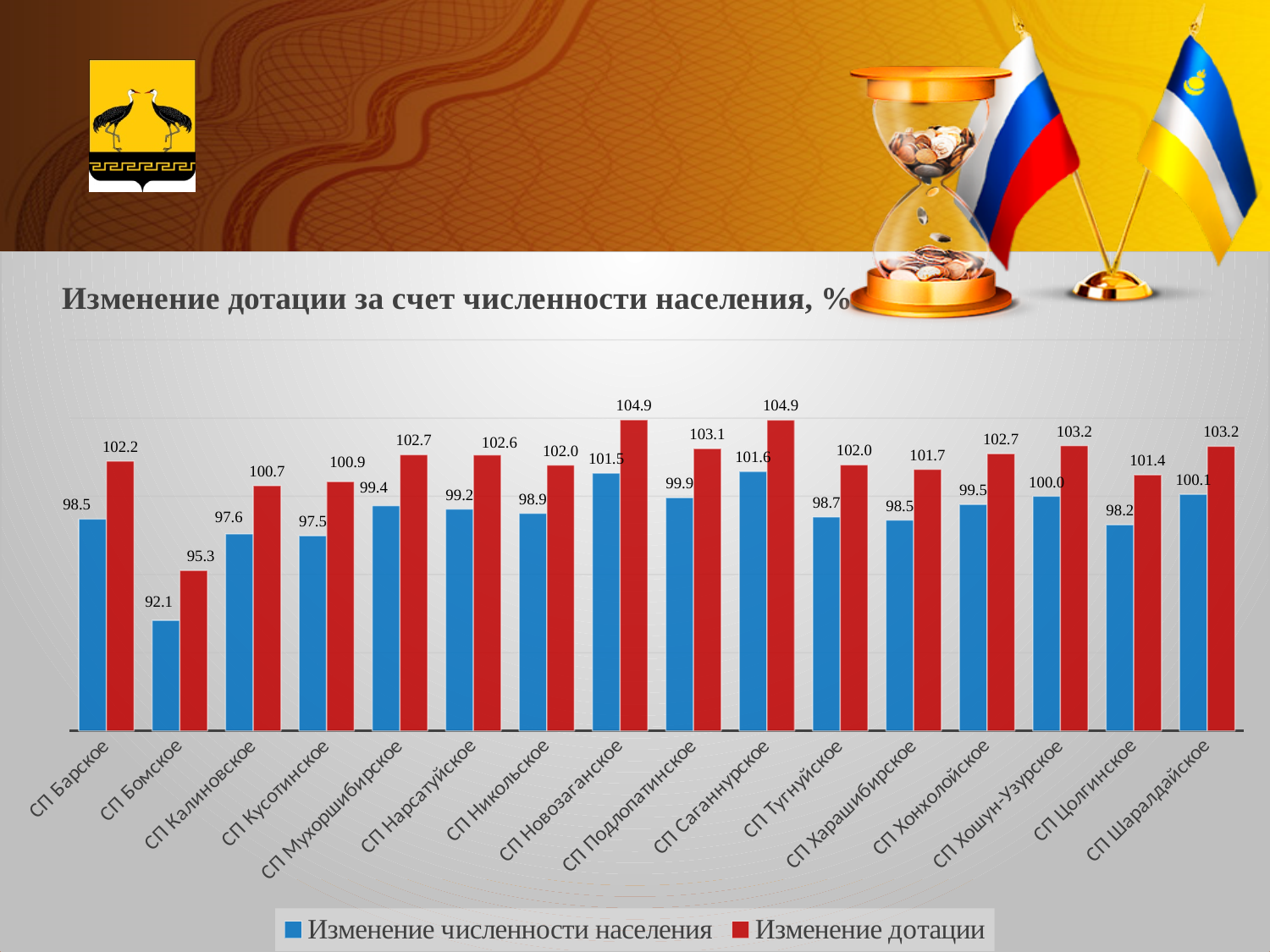
What is the difference between Изменение дотации and Изменение численности населения for СП Бомское? 3.2 What is the value of Изменение численности населения for СП Бомское? 92.1 What is the value of Изменение численности населения for СП Хошун-Узурское? 100.0 How many series does the legend list? 2 Which is larger for СП Калиновское: Изменение численности населения or Изменение дотации? Изменение дотации What is the value of Изменение дотации for СП Цолгинское? 101.4 What type of chart is shown on the slide? Bar chart How many categories are shown on the x axis? 16 What is the value of Изменение дотации for СП Новозаганское? 104.9 Which category has the lowest value for Изменение численности населения? СП Бомское What is the difference between Изменение дотации and Изменение численности населения for СП Барское? 3.7 Which category has the lowest value for Изменение дотации? СП Бомское